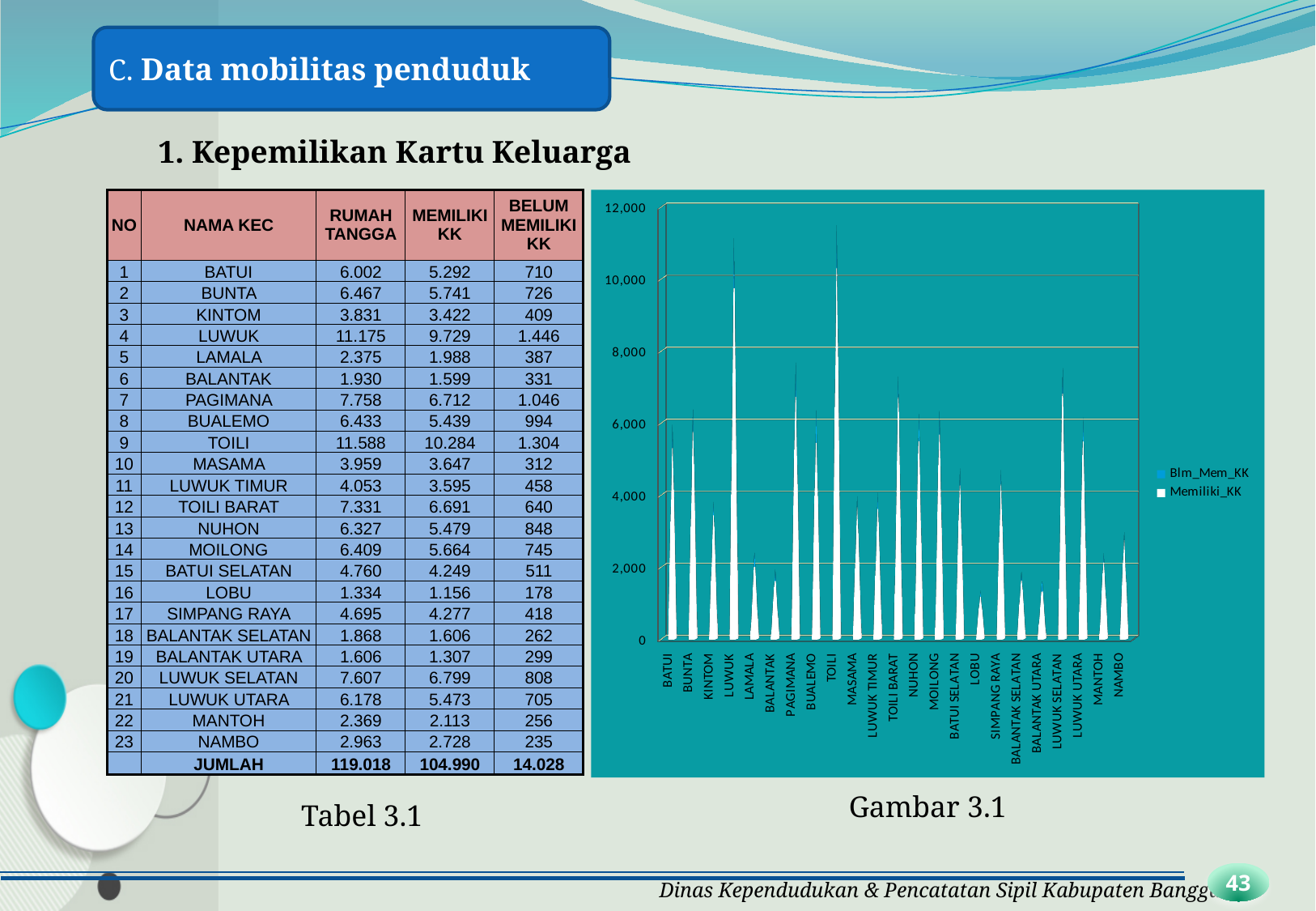
In Gambar 3.1, which kecamatan has the highest Memiliki_KK value? TOILI How many series does the legend of Gambar 3.1 list? 2 In Gambar 3.1, which has the larger Memiliki_KK value, LUWUK or LAMALA? LUWUK What are the two series named in the legend of Gambar 3.1? Blm_Mem_KK and Memiliki_KK In Gambar 3.1, is the Memiliki_KK value for MANTOH greater or less than 4,000? less What kind of chart is Gambar 3.1? bar chart In Gambar 3.1, which has the larger Memiliki_KK value, PAGIMANA or BALANTAK? PAGIMANA In Gambar 3.1, is the Memiliki_KK value for LUWUK greater or less than 8,000? greater In Gambar 3.1, which kecamatan has the lowest Memiliki_KK value? LOBU In Gambar 3.1, is the Memiliki_KK value for LOBU greater or less than 2,000? less How many kecamatan categories are shown along the x axis of Gambar 3.1? 23 What is the highest value shown on the vertical axis of Gambar 3.1? 12,000